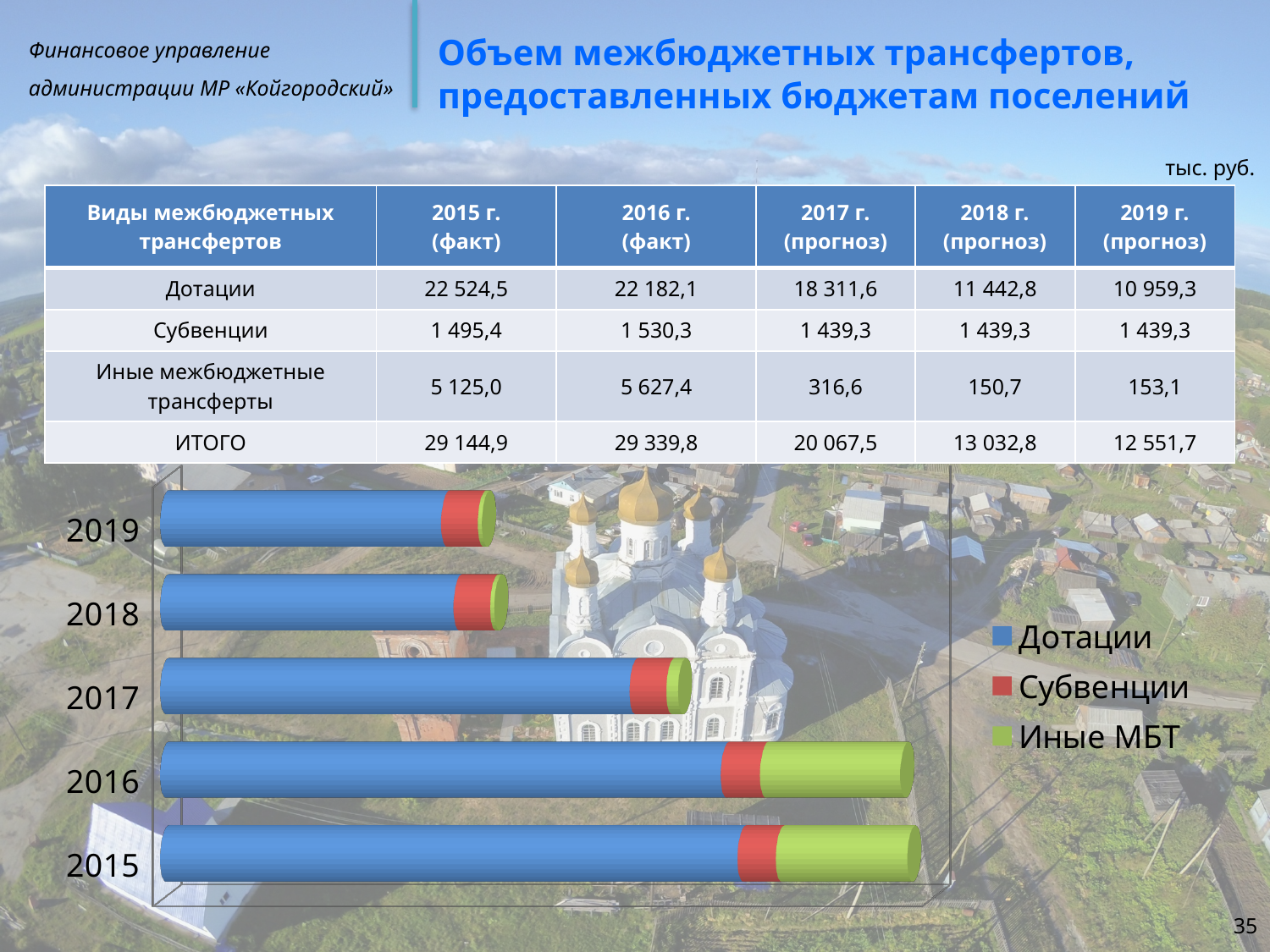
What is the difference between Субвенции in 2016 г. (факт) and 2015 г. (факт)? 34,9 What is the value of Дотации for 2017 г. (прогноз)? 18 311,6 Which year has the lowest total of interbudget transfers? 2019 What is the value of Иные межбюджетные трансферты for 2018 г. (прогноз)? 150,7 Do the total interbudget transfers rise or fall from 2016 to 2019? fall What colour represents Дотации in the bar chart? blue How many series does the chart legend list? 3 Which year has the larger total of interbudget transfers, 2017 or 2018? 2017 How many years are plotted in the bar chart? 5 What kind of chart is shown on the slide? bar chart What are the three entries in the chart legend? Дотации, Субвенции, Иные МБТ What is the total (ИТОГО) of interbudget transfers for 2016 г. (факт)? 29 339,8